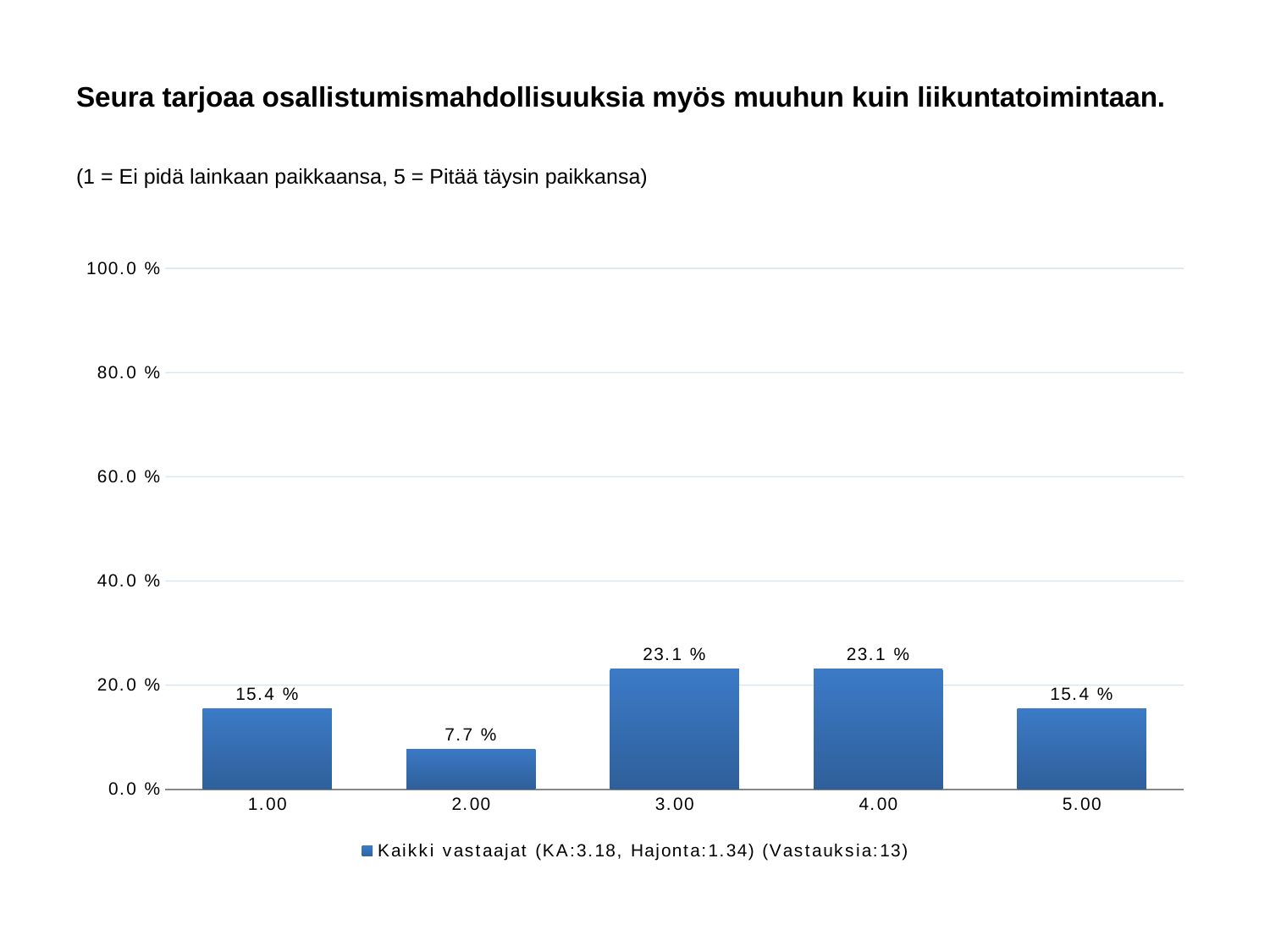
What is the value for category 1.00? 15.4 % How many responses (Vastauksia) does the legend report? 13 What is the value for category 5.00? 15.4 % What is the difference between the values for 1.00 and 2.00? 7.7 % What is the value for category 2.00? 7.7 % Is the value for 3.00 greater or less than 20.0 %? greater Which category has the lowest value? 2.00 Which is larger, the value for 4.00 or the value for 5.00? 4.00 What is the difference between the values for 3.00 and 2.00? 15.4 % What is the value for category 3.00? 23.1 % How many categories are shown on the x axis? 5 What kind of chart is shown on the slide? bar chart